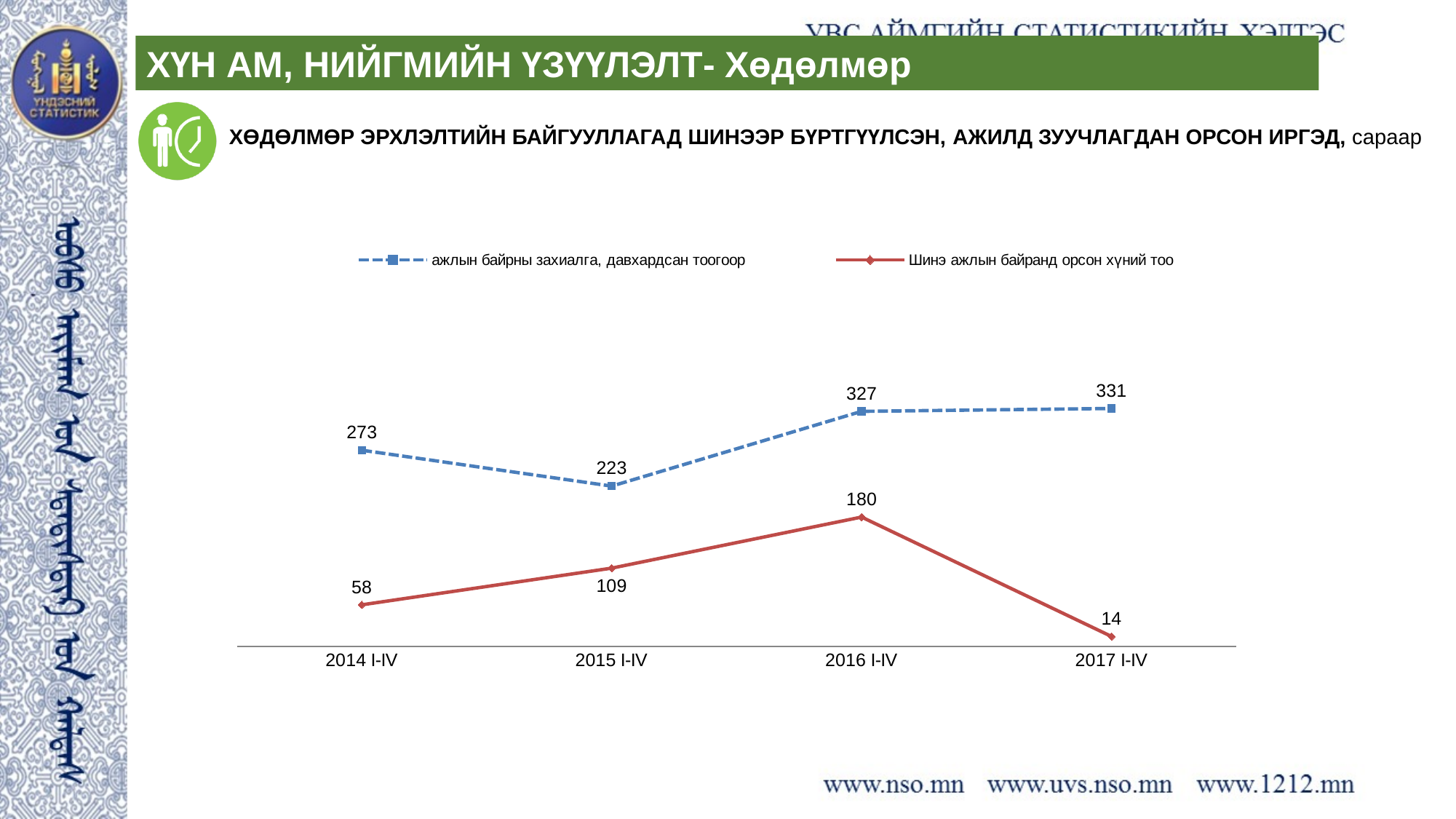
What kind of chart is shown on the slide? Line chart What is the value of "Шинэ ажлын байранд орсон хүний тоо" for 2017 I-IV? 14 In which period is "ажлын байрны захиалга, давхардсан тоогоор" highest? 2017 I-IV Which is larger: "ажлын байрны захиалга, давхардсан тоогоор" in 2014 I-IV or in 2015 I-IV? 2014 I-IV How many series does the legend list? 2 What is the difference between "ажлын байрны захиалга, давхардсан тоогоор" and "Шинэ ажлын байранд орсон хүний тоо" in 2014 I-IV? 215 How many periods are shown on the x axis? 4 In which period is "Шинэ ажлын байранд орсон хүний тоо" highest? 2016 I-IV What is the value of "Шинэ ажлын байранд орсон хүний тоо" for 2015 I-IV? 109 By how much did "Шинэ ажлын байранд орсон хүний тоо" fall from 2016 I-IV to 2017 I-IV? 166 In which period is "Шинэ ажлын байранд орсон хүний тоо" lowest? 2017 I-IV What is the value of "ажлын байрны захиалга, давхардсан тоогоор" for 2016 I-IV? 327